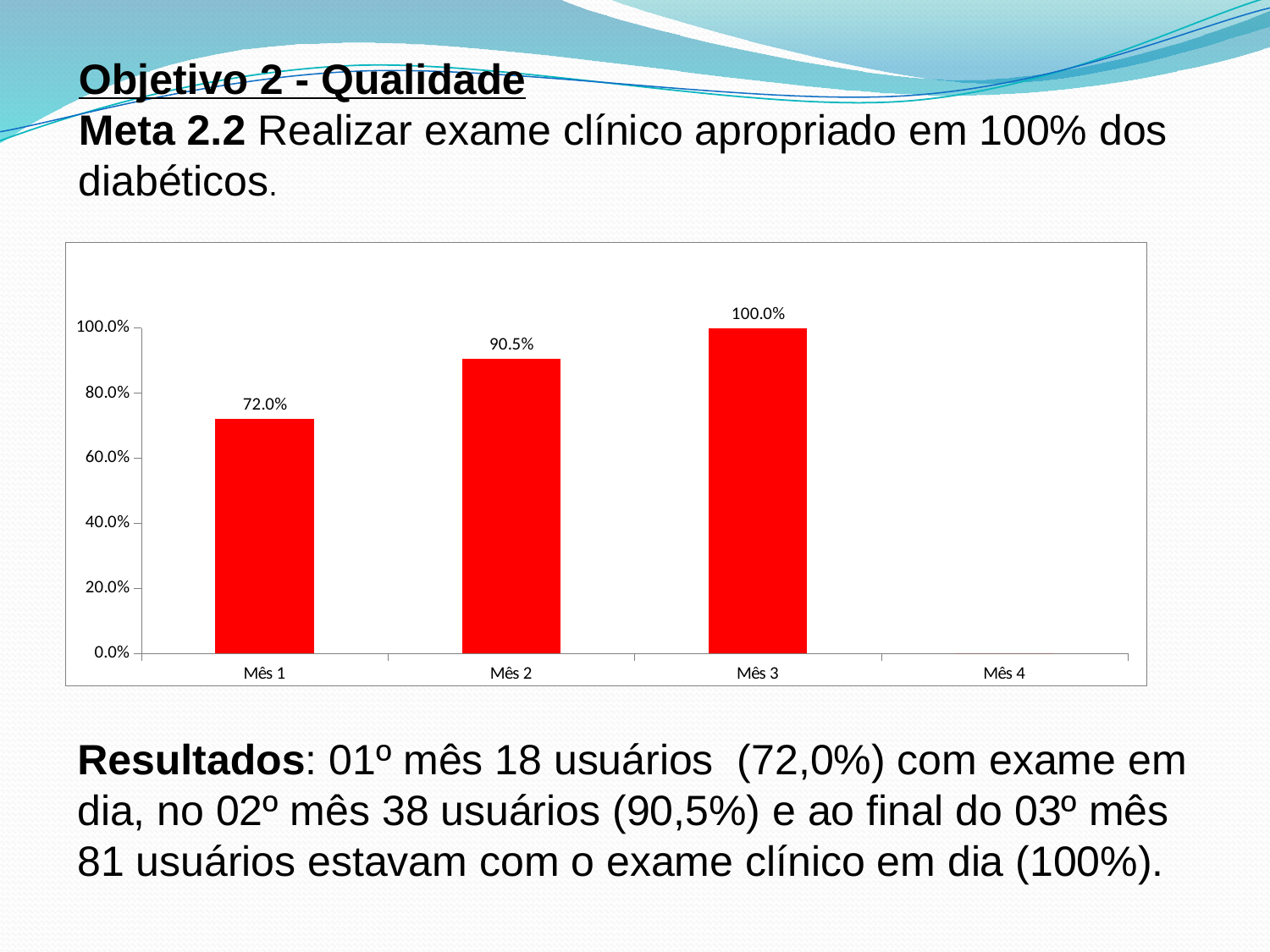
Do the values rise or fall from Mês 1 to Mês 3? rise Is the value for Mês 1 greater or less than 80.0%? less Which is larger, the value for Mês 1 or the value for Mês 2? Mês 2 What is the value shown for Mês 1? 72.0% Which month has the highest value in the chart? Mês 3 How many month categories are labelled on the x axis? 4 What is the value shown for Mês 2? 90.5% Among the months with a plotted bar, which has the lowest value? Mês 1 What is the value shown for Mês 3? 100.0% What is the difference between the values for Mês 3 and Mês 2? 9.5% What is the difference between the values for Mês 2 and Mês 1? 18.5% What kind of chart is shown on the slide? bar chart